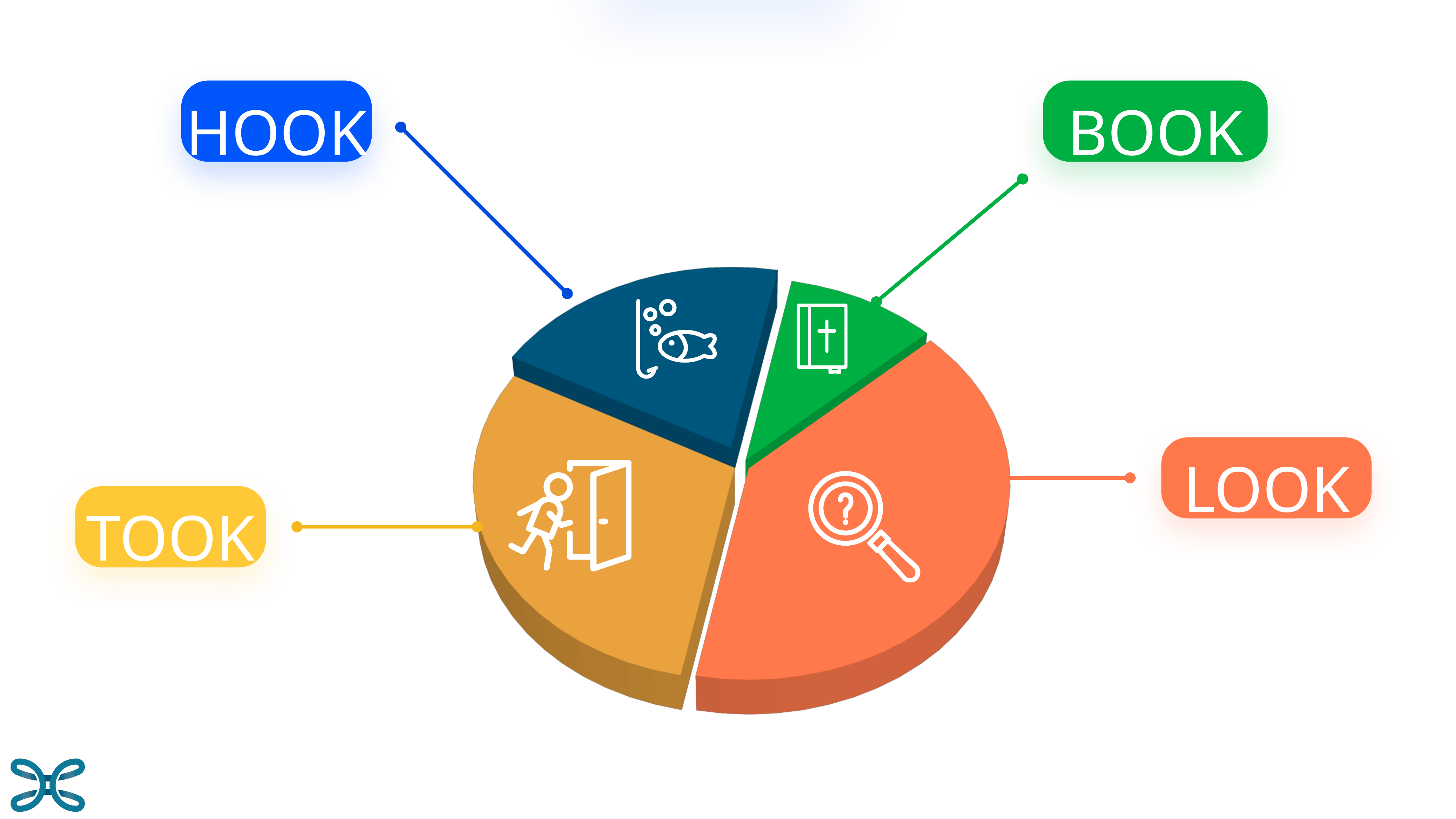
What colour is the HOOK slice of the pie chart? dark blue Which slice is larger, LOOK or BOOK? LOOK Which slice is larger, TOOK or HOOK? TOOK Which slice of the pie chart is the smallest? BOOK What colour is the LOOK slice of the pie chart? orange Which slice of the pie chart is the largest? LOOK What kind of chart is shown on the slide? pie chart Which slice is larger, TOOK or BOOK? TOOK How many slices does the pie chart have? 4